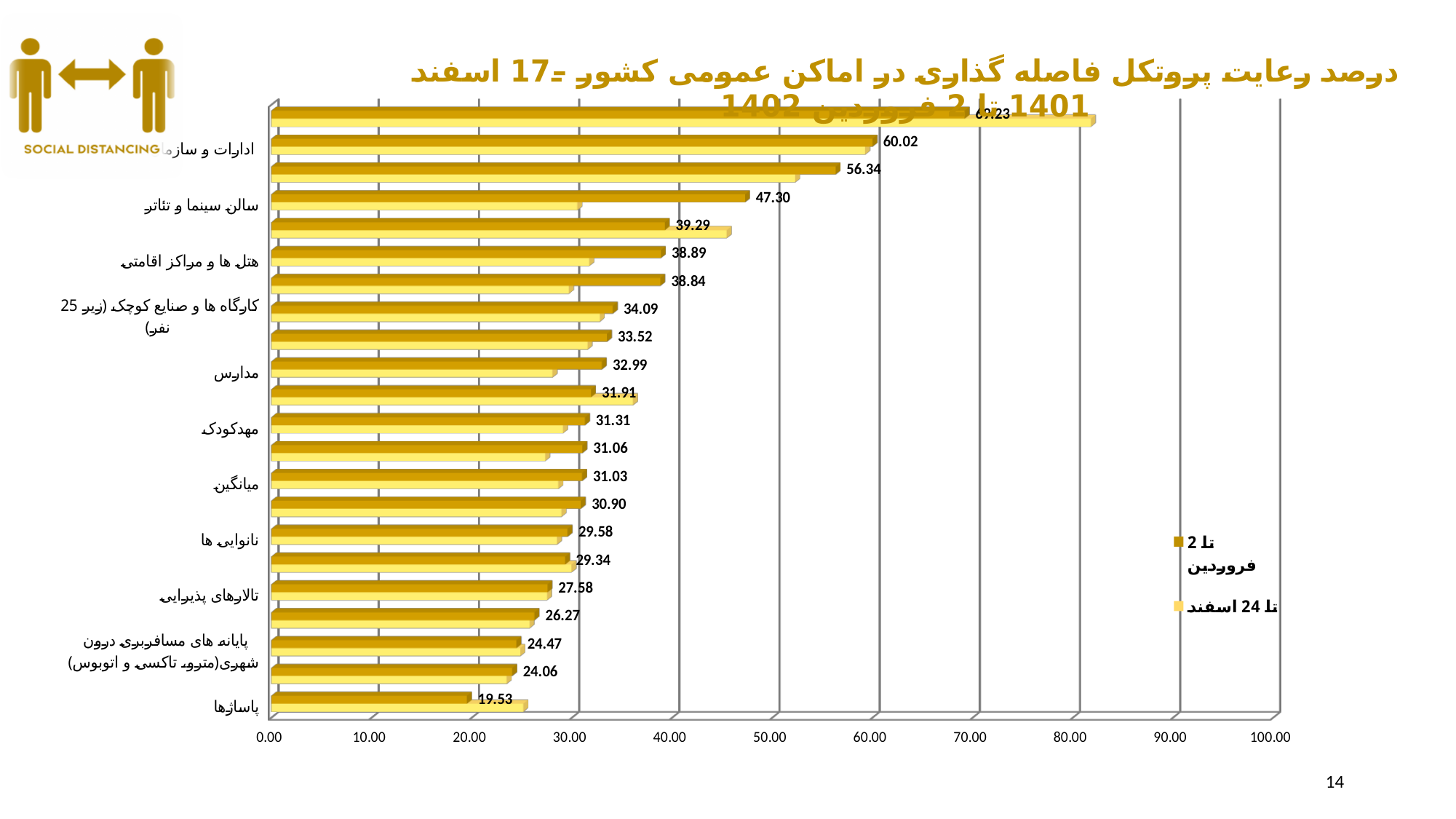
Is the تا 24 اسفند value for پاساژها greater or less than 20.00? greater What is the value for پاساژها in the تا 2 فروردین series? 19.53 What is the value for مدارس in the تا 2 فروردین series? 32.99 Which series is shown in the darker gold colour? تا 2 فروردین What kind of chart is shown on the slide? bar chart Is the تا 24 اسفند value for سالن سینما و تئاتر greater or less than 40.00? less What is the difference between the تا 2 فروردین values for سالن سینما و تئاتر and پاساژها? 27.77 What is the value for سالن سینما و تئاتر in the تا 2 فروردین series? 47.30 Which labelled category has the lowest value in the تا 2 فروردین series? پاساژها What is the value for میانگین in the تا 2 فروردین series? 31.03 How many series does the legend list? 2 Which has a larger تا 2 فروردین value, مدارس or مهدکودک? مدارس